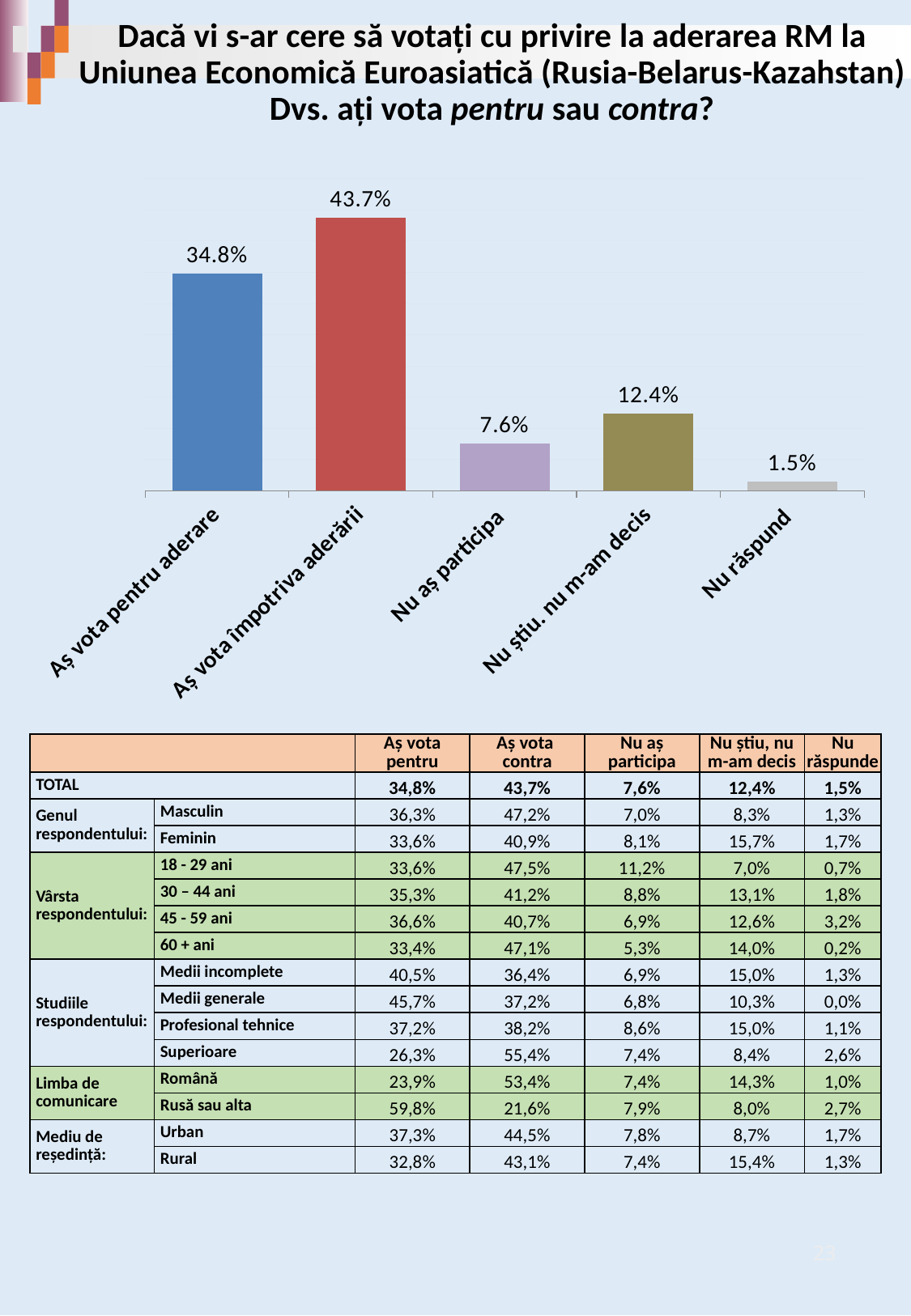
What is the difference between "Nu știu, nu m-am decis" and "Nu aș participa"? 4.8% Which category has the lowest value? Nu răspund How many categories are shown in the chart? 5 What is the value for "Nu aș participa"? 7.6% What is the value for "Aș vota pentru aderare"? 34.8% What is the value for "Nu răspund"? 1.5% What kind of chart is shown on the slide? Bar chart Which is larger, "Nu aș participa" or "Nu știu, nu m-am decis"? Nu știu, nu m-am decis What is the value for "Aș vota împotriva aderării"? 43.7% What is the value for "Nu știu, nu m-am decis"? 12.4% Which category has the highest value? Aș vota împotriva aderării What is the difference between "Aș vota împotriva aderării" and "Aș vota pentru aderare"? 8.9%